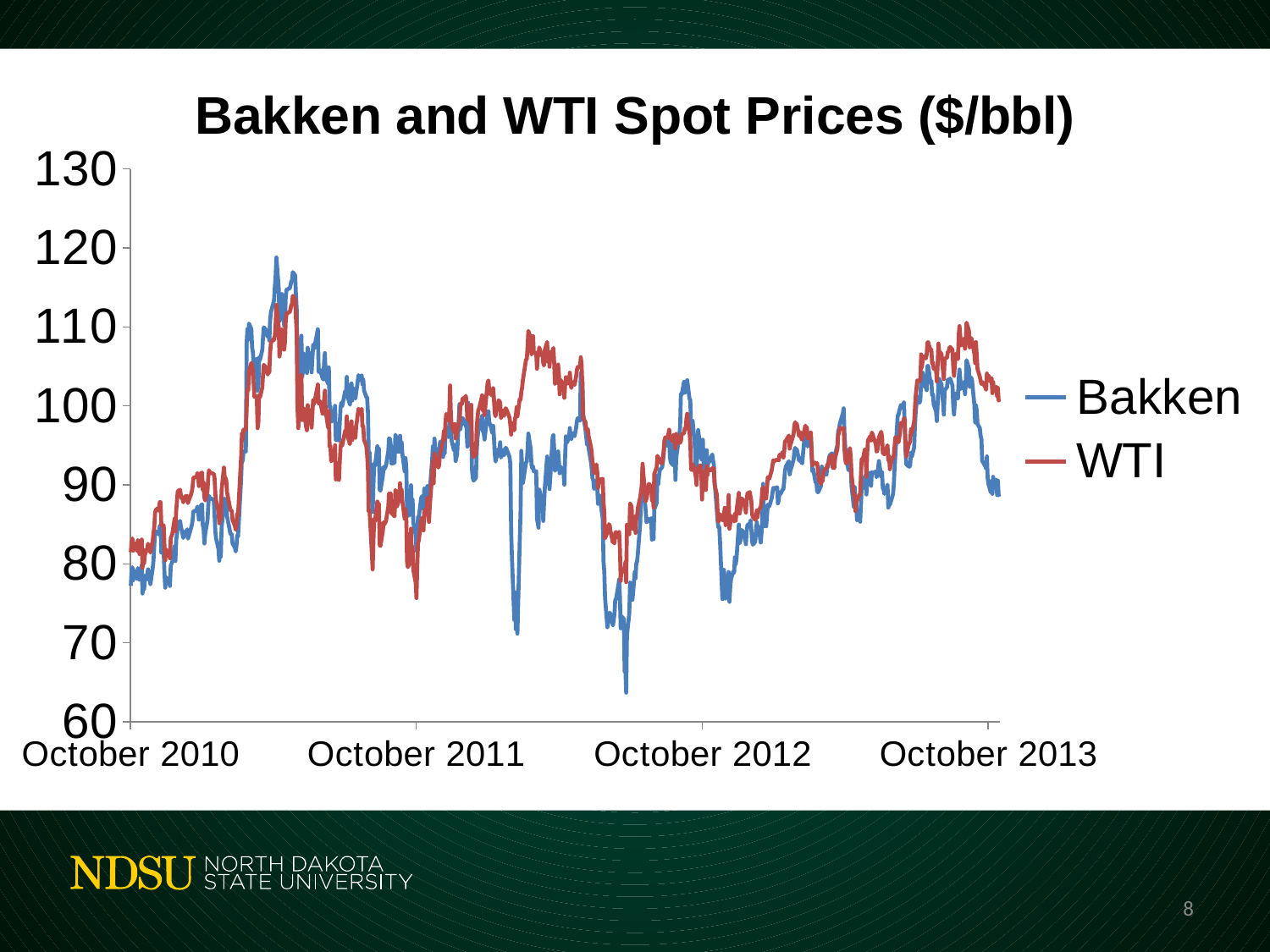
What kind of chart is shown on the slide? line chart Is the lowest point of the Bakken line greater or less than 70? less How many series does the legend list? 2 Which colour is used for the WTI line? red How many year labels are shown on the x axis? 4 Is the highest point of the WTI line greater or less than 120? less What is the title of the chart? Bakken and WTI Spot Prices ($/bbl) Which series reaches the lowest value on the chart? Bakken Is the lowest point of the WTI line greater or less than 70? greater Does the WTI line end higher or lower in October 2013 than it starts in October 2010? higher Which series reaches the highest peak on the chart? Bakken